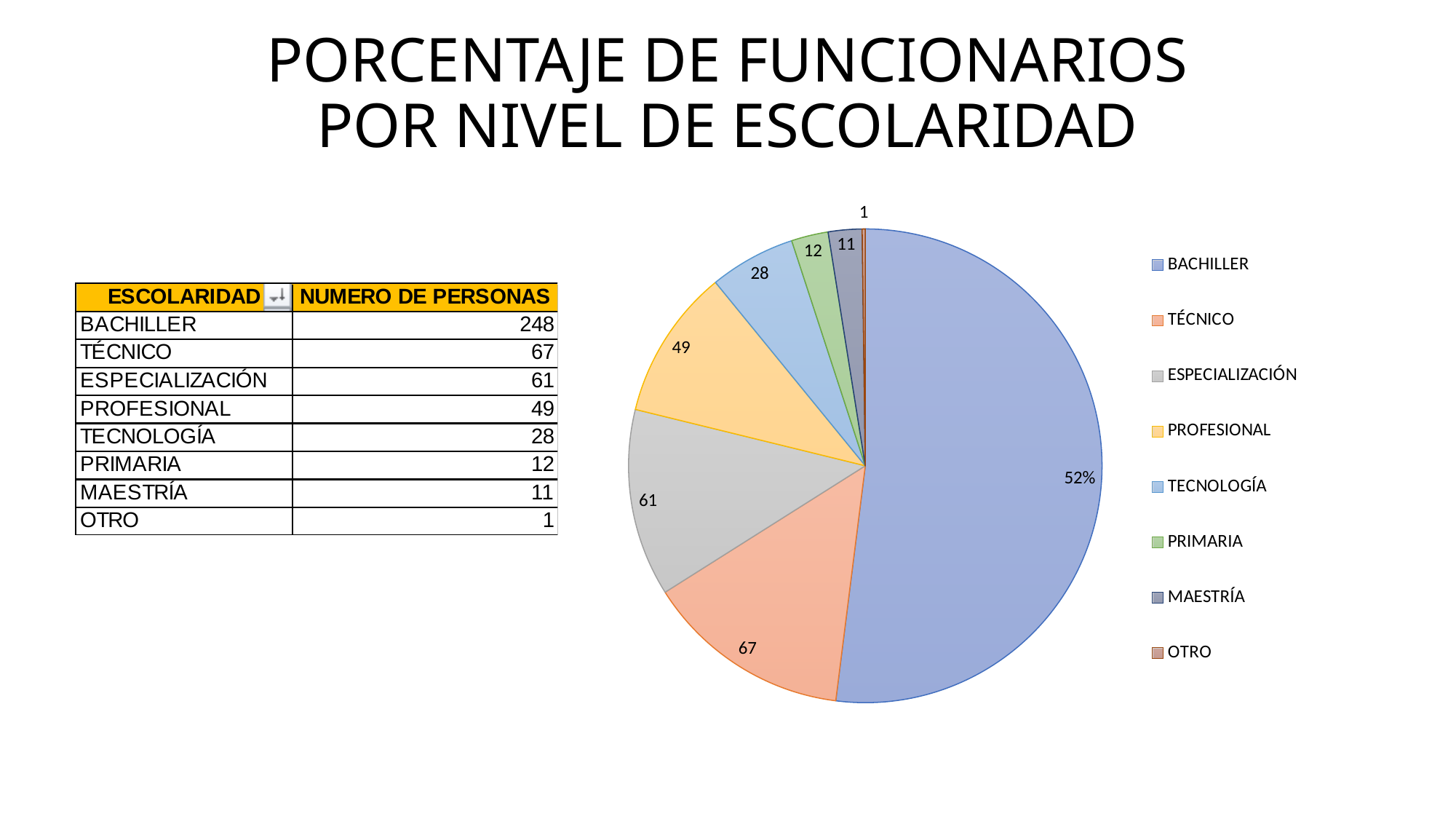
What is the difference between the TÉCNICO value and the PROFESIONAL value in the pie chart? 18 What value is shown on the TECNOLOGÍA slice of the pie chart? 28 What value is shown on the TÉCNICO slice of the pie chart? 67 Which category has the largest slice in the pie chart? BACHILLER What kind of chart is shown on the slide? pie chart What data label is shown on the BACHILLER slice of the pie chart? 52% How many entries does the legend of the pie chart list? 8 What colour is the PROFESIONAL slice in the pie chart? yellow How many slices does the pie chart have? 8 Which is larger in the pie chart, PRIMARIA or MAESTRÍA? PRIMARIA What value is shown on the ESPECIALIZACIÓN slice of the pie chart? 61 Which category has the smallest slice in the pie chart? OTRO